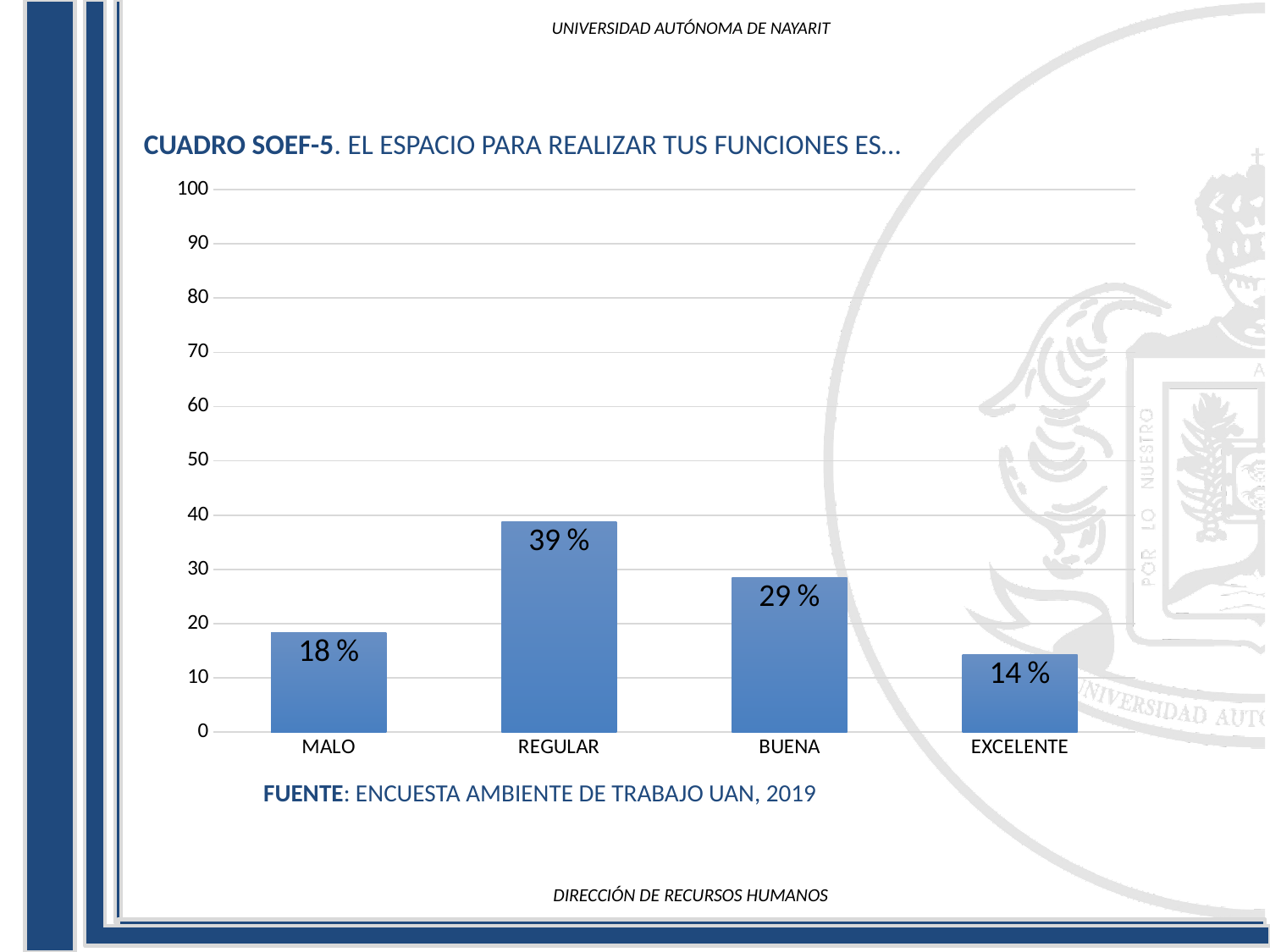
Which category has the highest value? REGULAR Which category has the lowest value? EXCELENTE What is the value for EXCELENTE? 14 % What is the difference between the values for REGULAR and BUENA? 10 % What is the value for MALO? 18 % What source is cited below the chart? ENCUESTA AMBIENTE DE TRABAJO UAN, 2019 Which is larger, the value for MALO or the value for BUENA? BUENA How many categories are shown on the x axis? 4 Is the value for BUENA greater or less than 40? less What is the maximum value shown on the y axis? 100 What kind of chart is shown on the slide? bar chart What is the value for REGULAR? 39 %